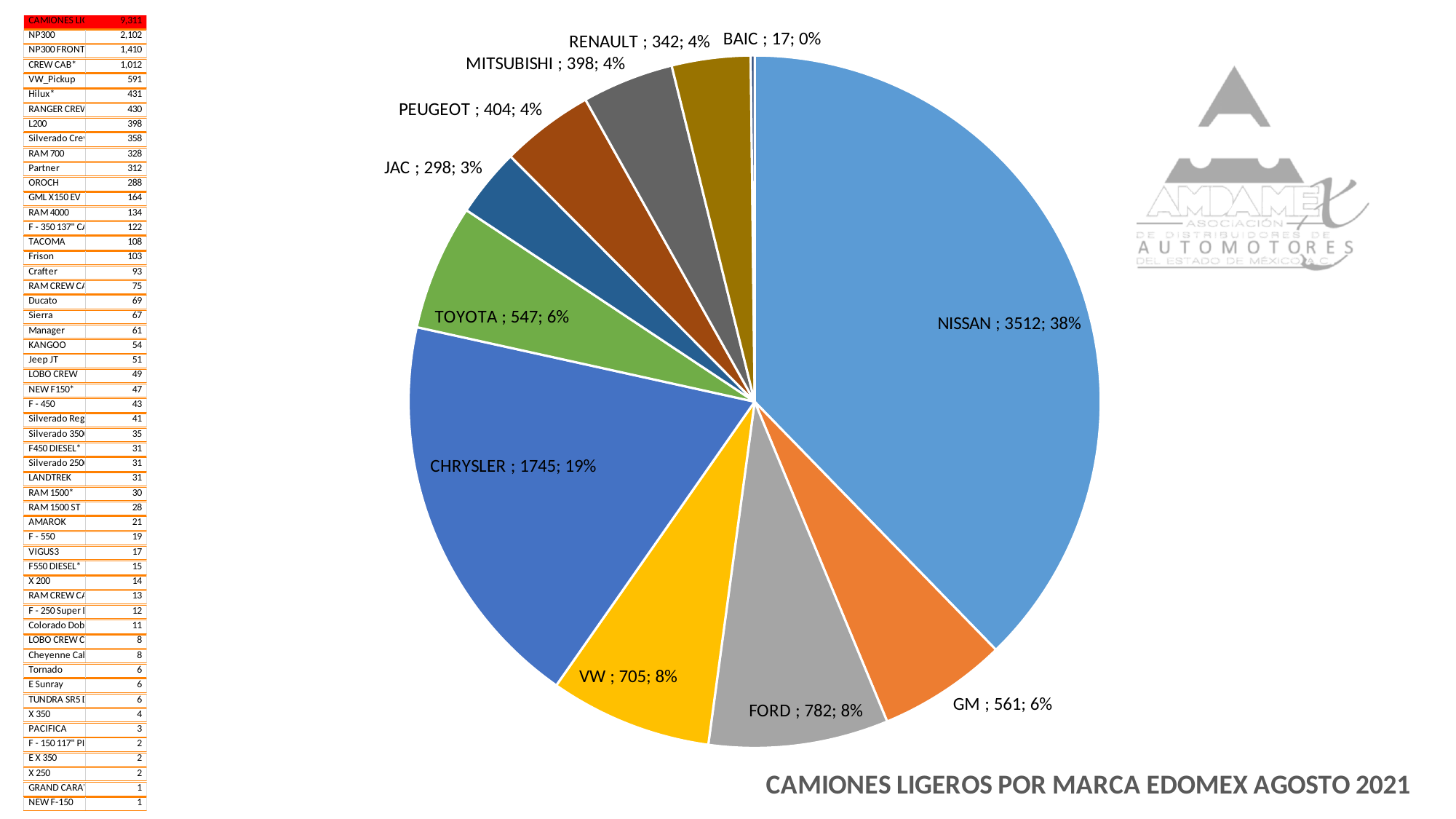
What is the value for PEUGEOT in the pie chart? 404 How many brands (slices) are shown in the pie chart? 11 What percentage share does FORD have in the pie chart? 8% Which brand has the largest slice in the pie chart? NISSAN What is the difference between the values for NISSAN and CHRYSLER? 1767 What percentage share does TOYOTA have in the pie chart? 6% What kind of chart is shown on the slide? Pie chart What is the value for CHRYSLER in the pie chart? 1745 Which is larger, the value for FORD or the value for VW? FORD What is the title of the chart? CAMIONES LIGEROS POR MARCA EDOMEX AGOSTO 2021 What is the value for NISSAN in the pie chart? 3512 Which brand has the smallest slice in the pie chart? BAIC